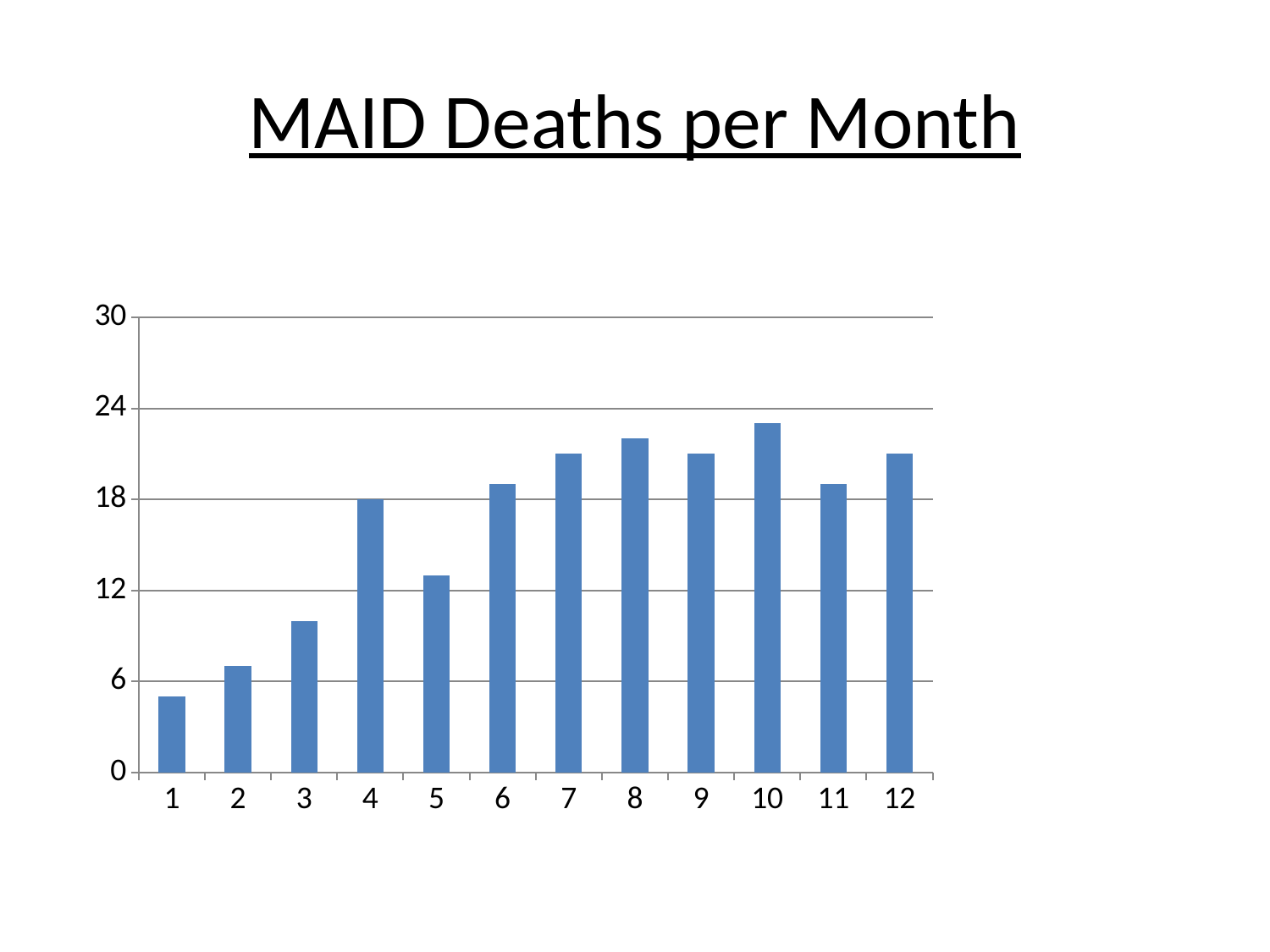
What is the value for month 4? 18 How many months (categories) are plotted on the x axis? 12 Is the value for month 3 greater or less than 12? less What kind of chart is shown on the slide? bar chart What is the title of the chart? MAID Deaths per Month Which month has the highest number of MAID deaths? 10 Do the values generally rise or fall from month 1 to month 12? rise Is the value for month 1 greater or less than 6? less Which is larger, the value for month 4 or the value for month 5? month 4 Which month has the lowest number of MAID deaths? 1 Is the value for month 7 greater or less than 18? greater